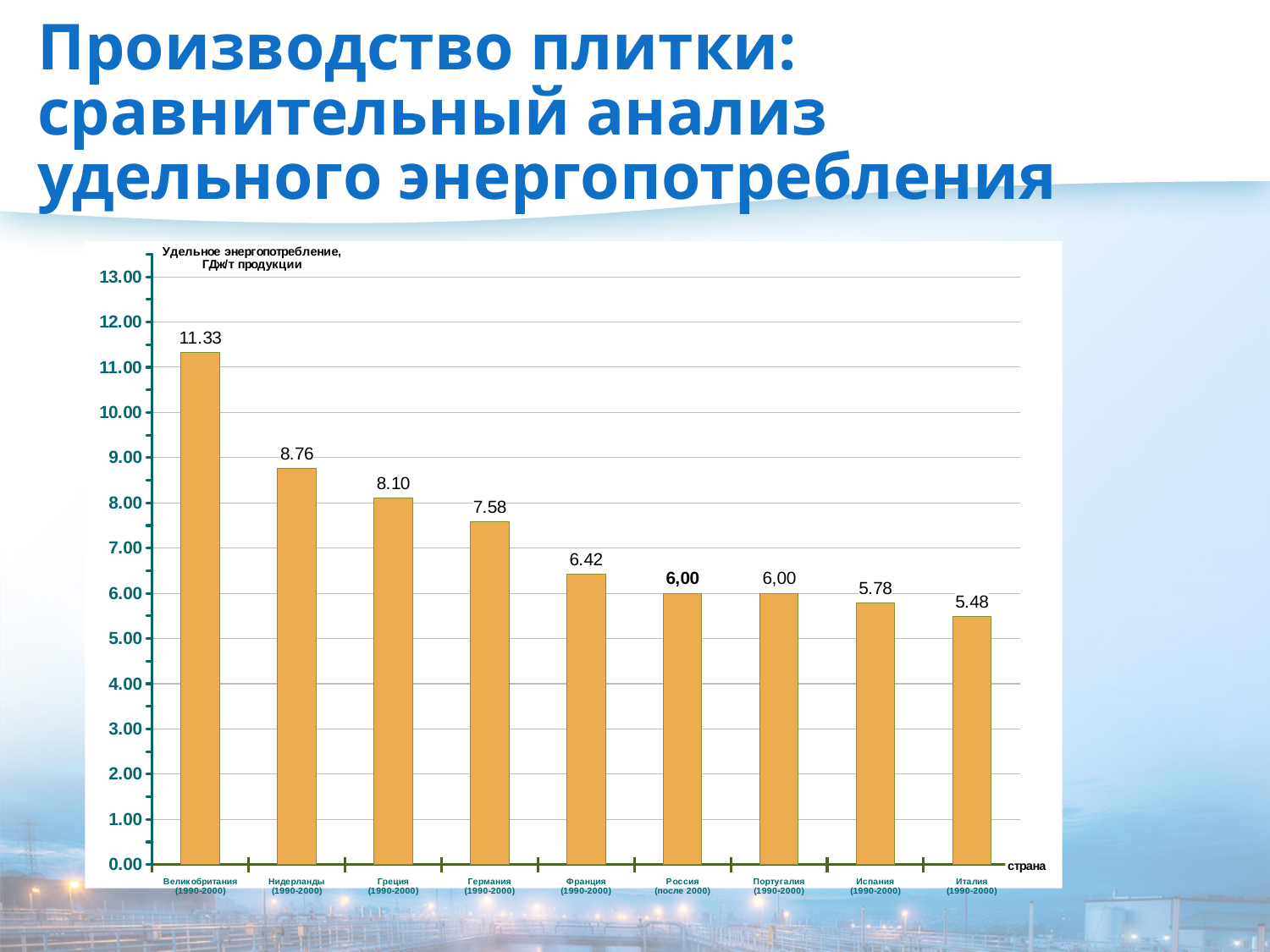
What unit is given for the y axis of the chart? ГДж/т продукции Which country has the lowest specific energy consumption? Италия Do the values rise or fall from left to right across the countries? fall What kind of chart is shown on the slide? bar chart What is the difference between the values for Нидерланды and Греция? 0.66 What is the value for Германия (1990-2000)? 7.58 Which country has the highest specific energy consumption? Великобритания Which has a larger value, Франция or Испания? Франция How many countries are shown on the chart? 9 What is the value for Россия (после 2000)? 6,00 What is the value for Великобритания (1990-2000)? 11.33 Is the value for Италия greater or less than 6.00? less